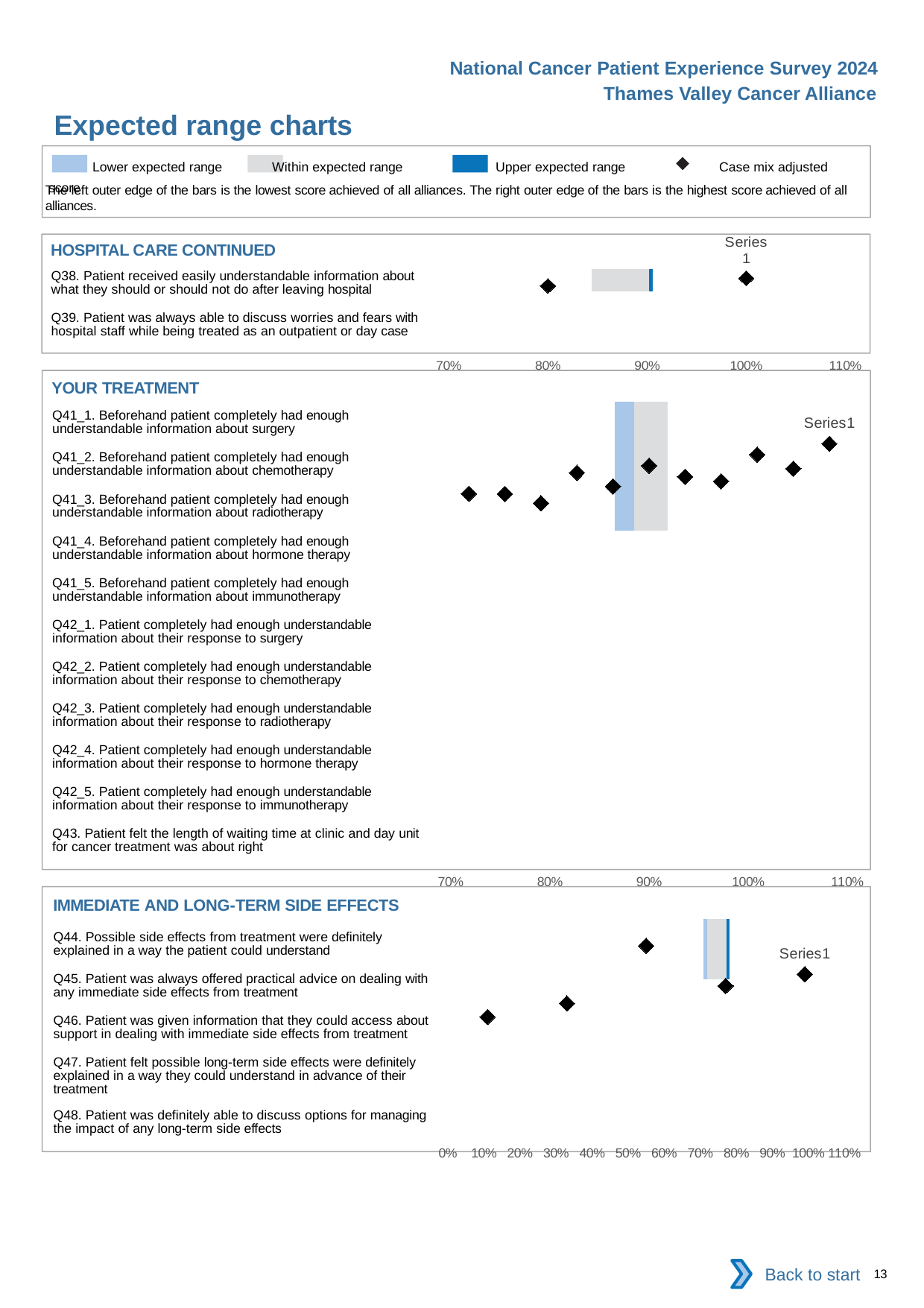
How many question categories are listed in the HOSPITAL CARE CONTINUED chart? 2 What is the lowest axis tick shown on the YOUR TREATMENT chart? 70% What series name is shown in the legend of the YOUR TREATMENT chart? Series1 What is the highest axis tick shown on the YOUR TREATMENT chart? 110% What is the title of the chart at the top of the slide? HOSPITAL CARE CONTINUED How many question categories are listed in the IMMEDIATE AND LONG-TERM SIDE EFFECTS chart? 5 What is the lowest axis tick shown on the IMMEDIATE AND LONG-TERM SIDE EFFECTS chart? 0% How many question categories are listed in the YOUR TREATMENT chart? 11 In the shared legend at the top of the slide, what does the diamond marker represent? Case mix adjusted score